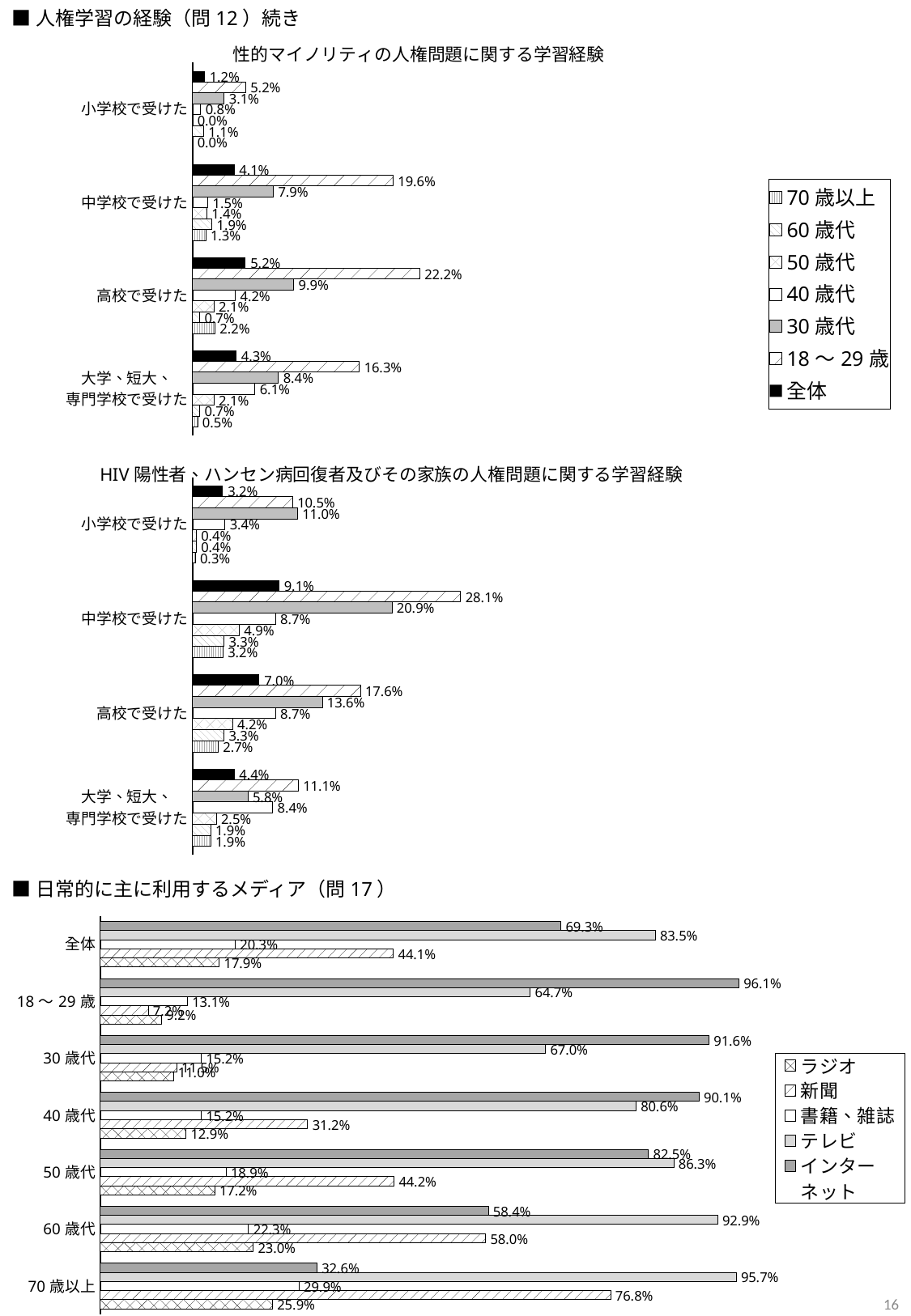
In the chart under 日常的に主に利用するメディア（問17）, which age group has the lowest インターネット value? 70歳以上 In the chart titled 性的マイノリティの人権問題に関する学習経験, what is the value for 18～29歳 in the 高校で受けた category? 22.2% In the chart titled HIV陽性者、ハンセン病回復者及びその家族の人権問題に関する学習経験, what is the value for 30歳代 in the 中学校で受けた category? 20.9% In the chart titled 性的マイノリティの人権問題に関する学習経験, how many series does the legend list? 7 In the chart titled HIV陽性者、ハンセン病回復者及びその家族の人権問題に関する学習経験, what is the difference between the 18～29歳 and 全体 values for 中学校で受けた? 19.0% In the chart titled 性的マイノリティの人権問題に関する学習経験, what is the 全体 value for 中学校で受けた? 4.1% What kind of chart is used under 日常的に主に利用するメディア（問17）? Bar chart In the chart titled 性的マイノリティの人権問題に関する学習経験, which age group has the highest value in the 大学、短大、専門学校で受けた category? 18～29歳 In the chart titled HIV陽性者、ハンセン病回復者及びその家族の人権問題に関する学習経験, how many categories are shown on the vertical axis? 4 In the chart under 日常的に主に利用するメディア（問17）, what is the テレビ value for 70歳以上? 95.7% In the chart titled HIV陽性者、ハンセン病回復者及びその家族の人権問題に関する学習経験, which is larger for 小学校で受けた: 18～29歳 or 30歳代? 30歳代 In the chart under 日常的に主に利用するメディア（問17）, what is the インターネット value for 18～29歳? 96.1%